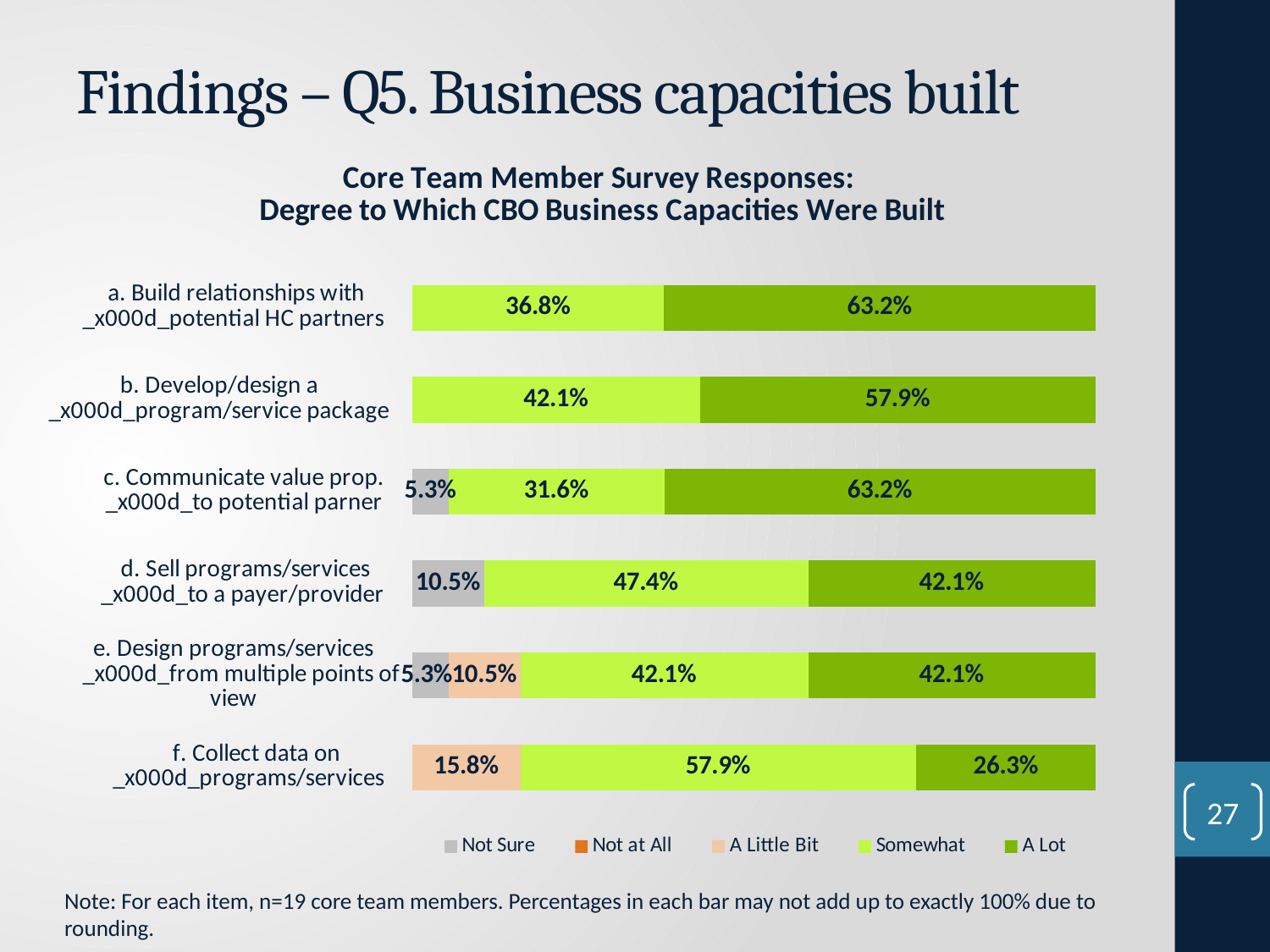
What is the 'A Little Bit' percentage for 'f. Collect data on programs/services'? 15.8% What percentage of core team members said 'A Lot' for 'a. Build relationships with potential HC partners'? 63.2% How many response categories does the legend list? 5 Which item has the highest 'Somewhat' percentage? f. Collect data on programs/services What percentage of respondents answered 'Somewhat' for 'd. Sell programs/services to a payer/provider'? 47.4% According to the note, how many core team members responded to each item? 19 What is the 'Not Sure' percentage for 'c. Communicate value prop. to potential parner'? 5.3% What is the difference between the 'A Lot' and 'Somewhat' percentages for 'b. Develop/design a program/service package'? 15.8 percentage points For 'd. Sell programs/services to a payer/provider', which is larger: the 'Somewhat' share or the 'A Lot' share? Somewhat How many items (categories) are shown in the chart? 6 What type of chart is shown on the slide? Stacked bar chart Which item has the lowest 'A Lot' percentage? f. Collect data on programs/services